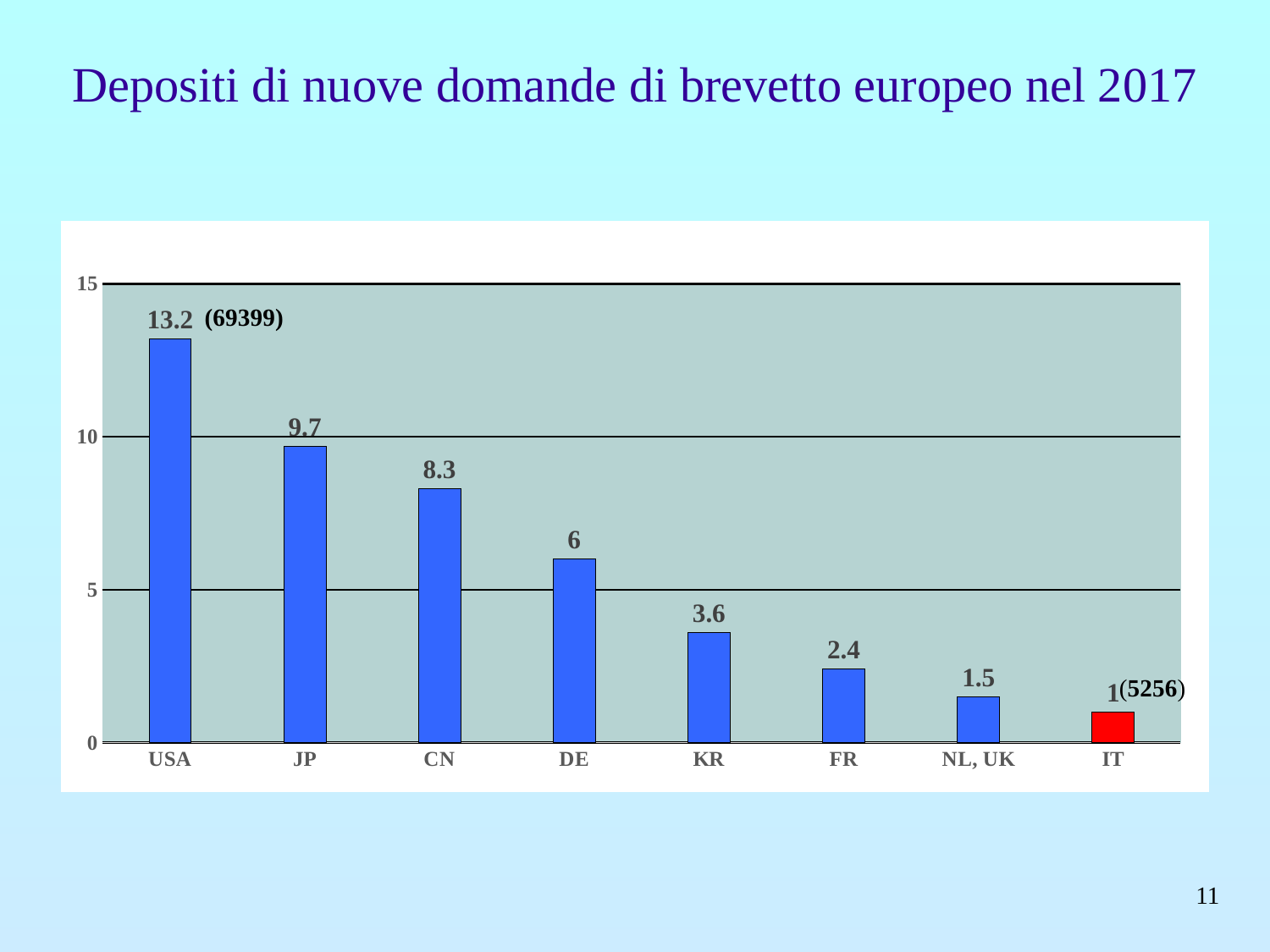
How many categories are shown on the x axis? 8 Which category has the highest value? USA What is the value for NL, UK? 1.5 Which is larger, the value for FR or the value for KR? KR What kind of chart is shown on the slide? Bar chart What is the difference between the values for JP and DE? 3.7 Which category has the lowest value? IT What is the value for KR? 3.6 Is the value for DE greater or less than 5? greater What is the value for CN? 8.3 Which bar is coloured red? IT What is the value for USA? 13.2